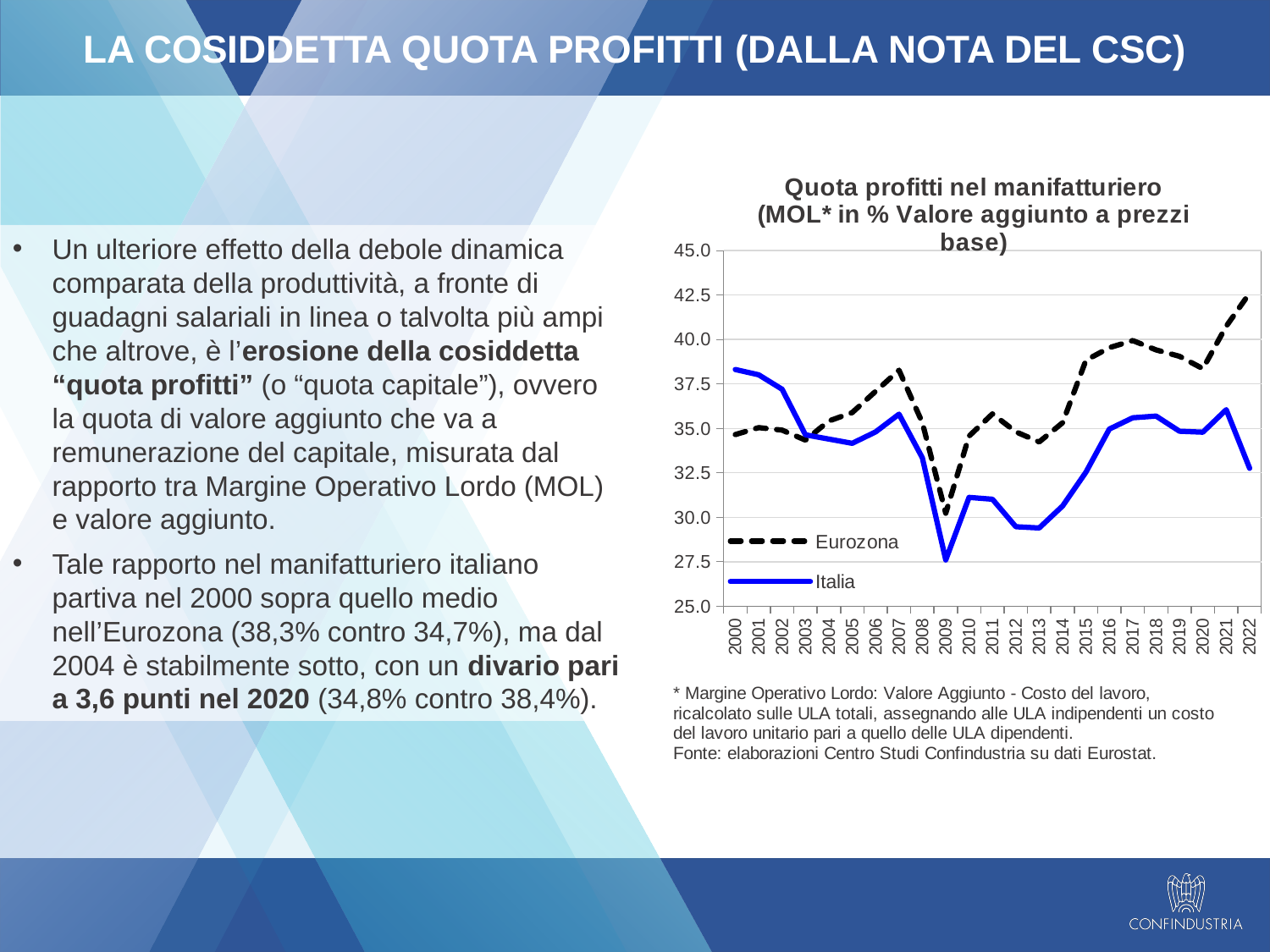
In 2022, which series has the higher value, Eurozona or Italia? Eurozona How many series does the chart legend list? 2 Which two series are listed in the chart legend? Eurozona and Italia What kind of chart is shown on the slide? line chart In 2000, which series has the higher value, Eurozona or Italia? Italia In which year does the Eurozona series reach its highest value? 2022 Does the Italia series rise or fall between 2007 and 2009? fall Is the value for Italia in 2022 greater or less than 35.0? less Is the value for Italia in 2009 greater or less than 30.0? less In which year does the Italia series reach its lowest value? 2009 Is the value for Eurozona in 2022 greater or less than 40.0? greater How many years are plotted along the x axis of the chart? 23